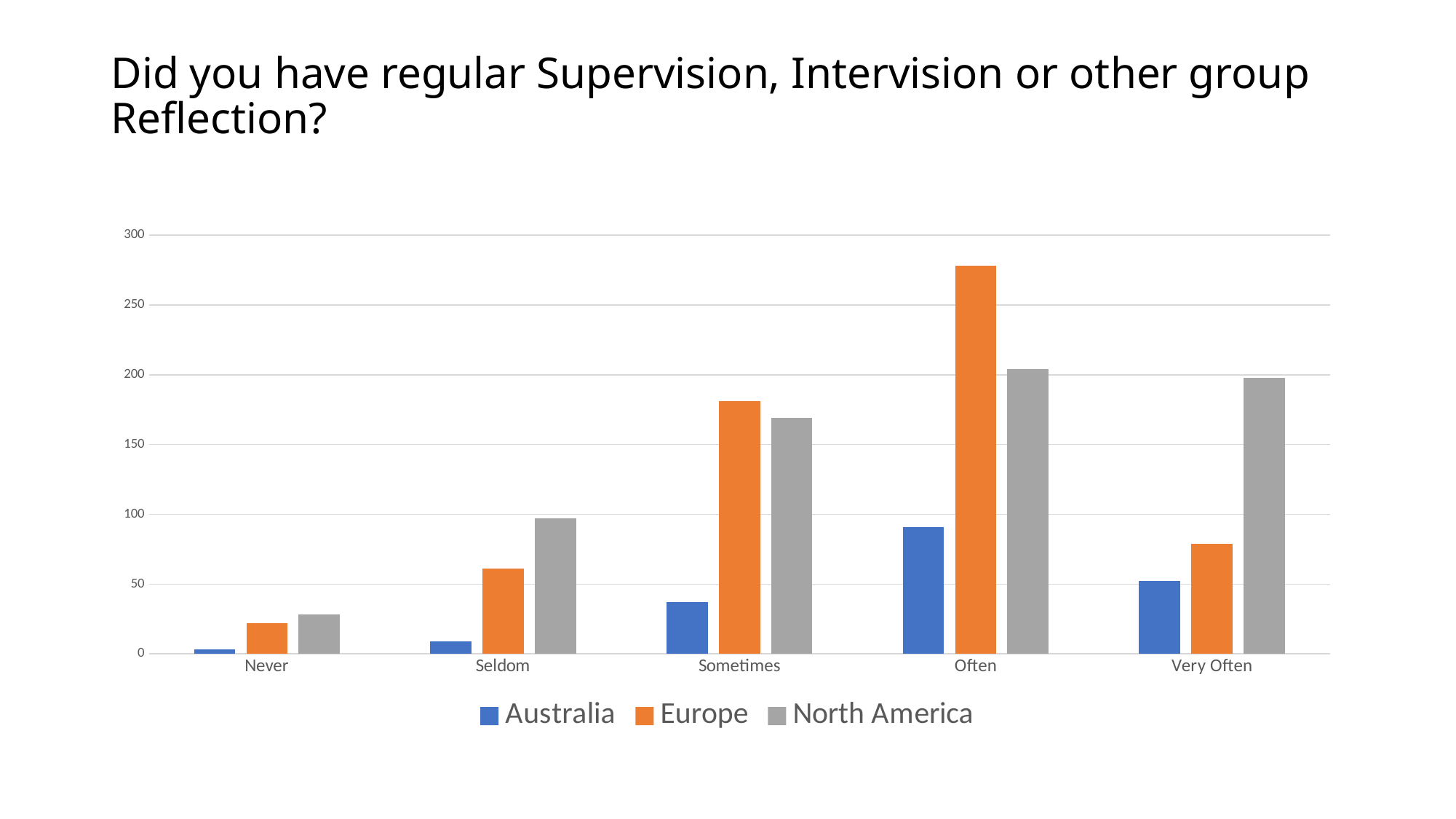
Which is larger in the Very Often category, Europe or North America? North America Which is larger in the Sometimes category, Europe or Australia? Europe Is the value for Europe in the Often category greater or less than 250? greater Which category has the lowest value for Australia? Never Which series has the highest value in the Seldom category? North America Is the value for Australia in the Often category greater or less than 100? less What kind of chart is shown on the slide? bar chart How many categories are shown on the x axis? 5 How many series does the legend list? 3 Which category has the highest value for Europe? Often Which series is shown in orange in the legend? Europe